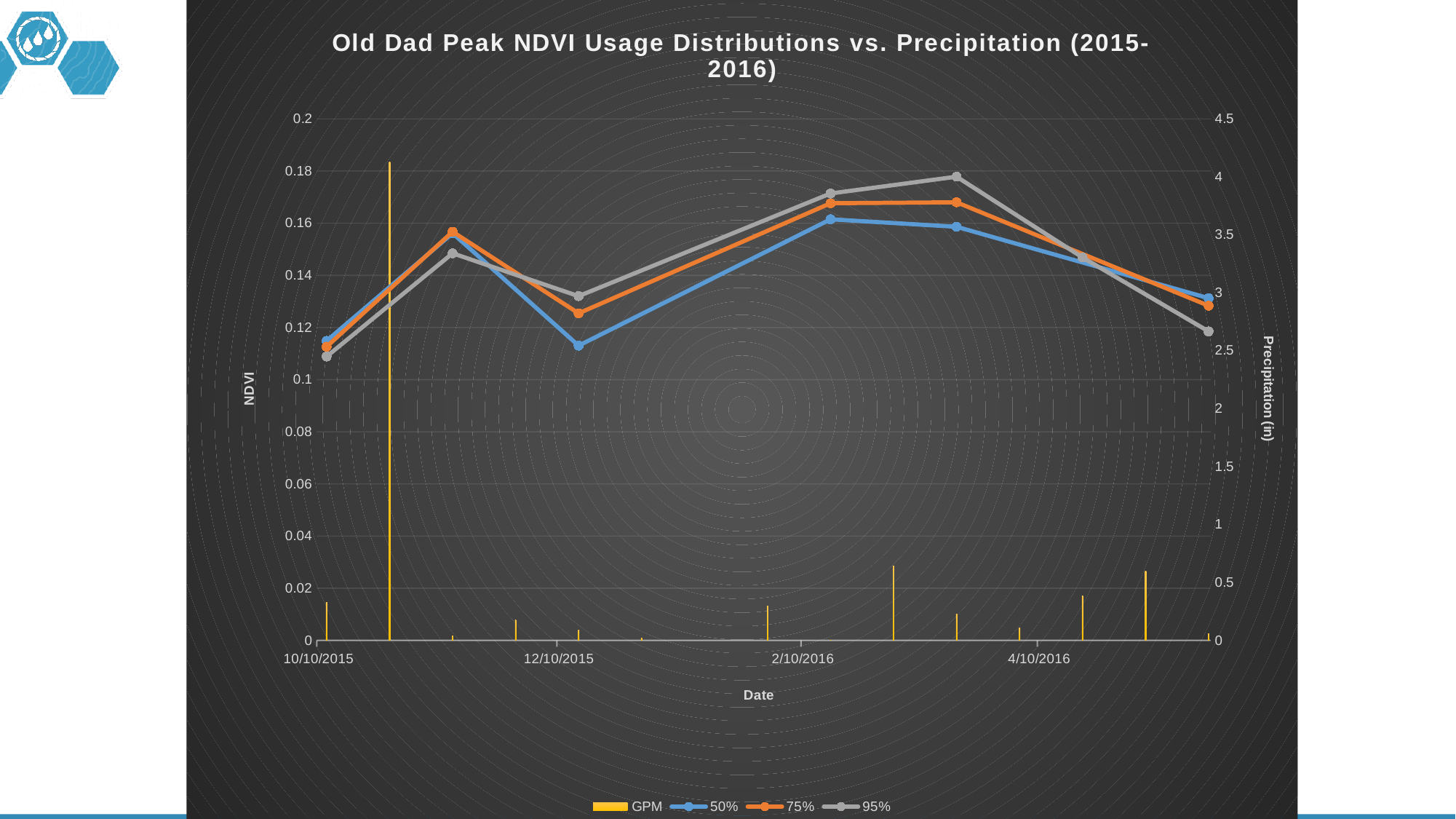
Is the peak value of the 95% line greater or less than 0.16? greater What kind of chart is this? Combined line and bar chart What is the title of the chart? Old Dad Peak NDVI Usage Distributions vs. Precipitation (2015-2016) Which series reaches the highest NDVI value on the chart? 95% Which series has the lowest NDVI value at 12/10/2015? 50% Is the tallest GPM precipitation bar greater or less than 3.5 inches? greater At the last date on the chart, which is larger, the 50% line or the 95% line? 50% How many data points does the 50% line have? 6 Is the value of the 50% line at 12/10/2015 greater or less than 0.12? less How many series does the legend list? 4 What is the title of the right-hand vertical axis? Precipitation (in) Between 12/10/2015 and 2/10/2016, do the NDVI lines rise or fall? rise